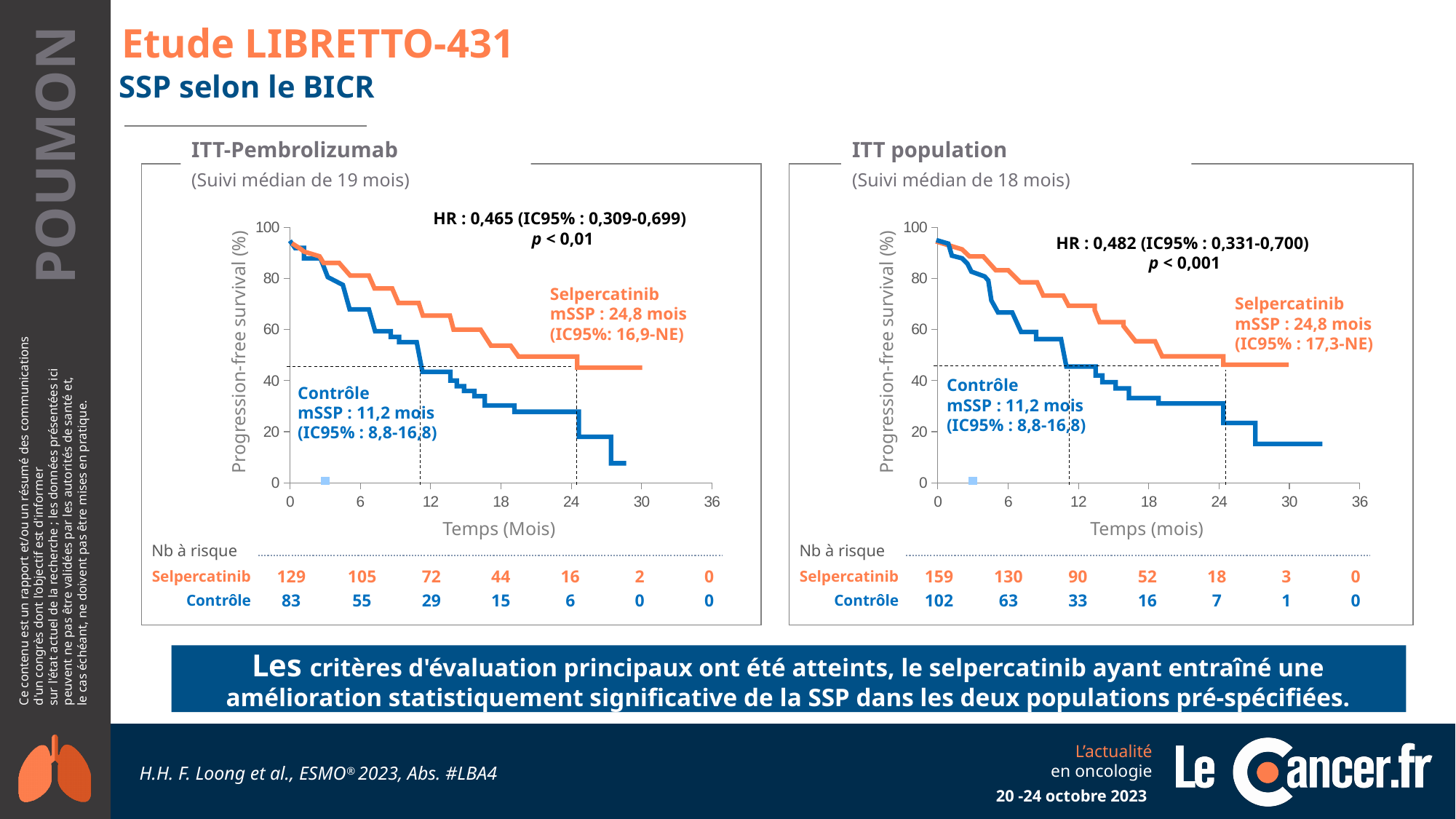
In the ITT-Pembrolizumab chart, what is the median PFS (mSSP) for Selpercatinib? 24,8 mois What is the median follow-up stated for the ITT population chart? 18 mois In the ITT population chart, which arm has more patients at risk at 18 months, Selpercatinib or Contrôle? Selpercatinib In the ITT-Pembrolizumab chart, how many Contrôle patients are at risk at 6 months? 55 In the ITT population chart, is the Contrôle curve at 24 months greater or less than 40%? less In the ITT-Pembrolizumab chart, what is the median PFS (mSSP) for Contrôle? 11,2 mois In the ITT population chart, how many Selpercatinib patients are at risk at 12 months? 90 What kind of chart is shown in the ITT-Pembrolizumab panel? Line chart (Kaplan-Meier survival curve) In the ITT-Pembrolizumab chart, what is the p-value shown? p < 0,01 In the ITT population chart, what hazard ratio is reported? 0,482 (IC95% : 0,331-0,700) In the ITT-Pembrolizumab chart, what is the difference between the number of Selpercatinib and Contrôle patients at risk at 0 months? 46 In the ITT-Pembrolizumab chart, do the survival curves rise or fall along the x axis? fall